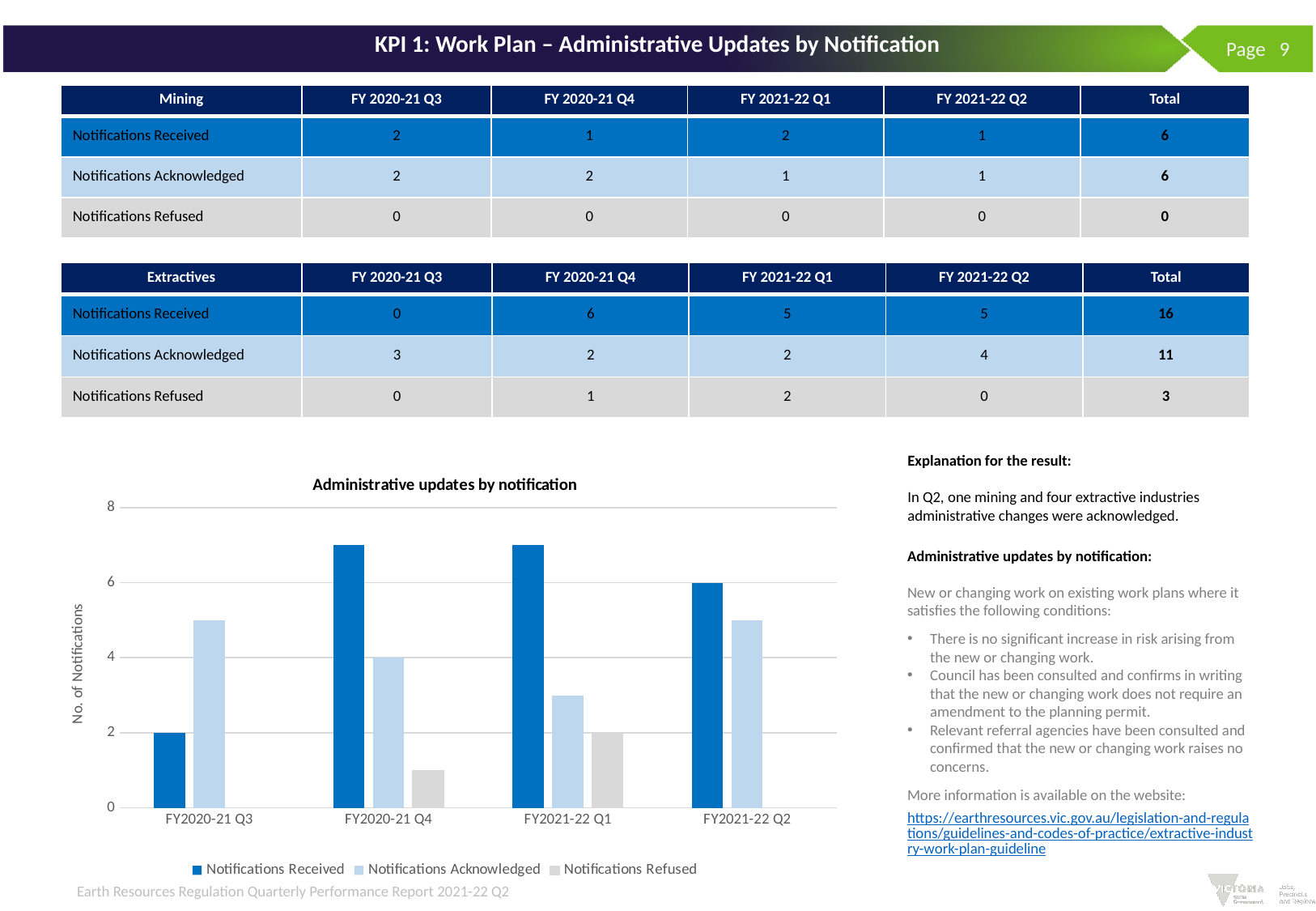
What type of chart is shown on the slide? bar chart What is the value of Notifications Received for FY2021-22 Q2? 6 What is the title of the chart? Administrative updates by notification How many series does the chart legend list? 3 What is the value of Notifications Acknowledged for FY2020-21 Q4? 4 Is the value of Notifications Acknowledged for FY2021-22 Q1 greater or less than 4? less What is the value of Notifications Received for FY2020-21 Q3? 2 Which quarter has the lowest value for Notifications Received? FY2020-21 Q3 How many quarters are shown on the x axis of the chart? 4 In FY2020-21 Q3, which is larger: Notifications Received or Notifications Acknowledged? Notifications Acknowledged Which quarter has the highest value for Notifications Refused? FY2021-22 Q1 Is the value of Notifications Received for FY2020-21 Q4 greater or less than 6? greater